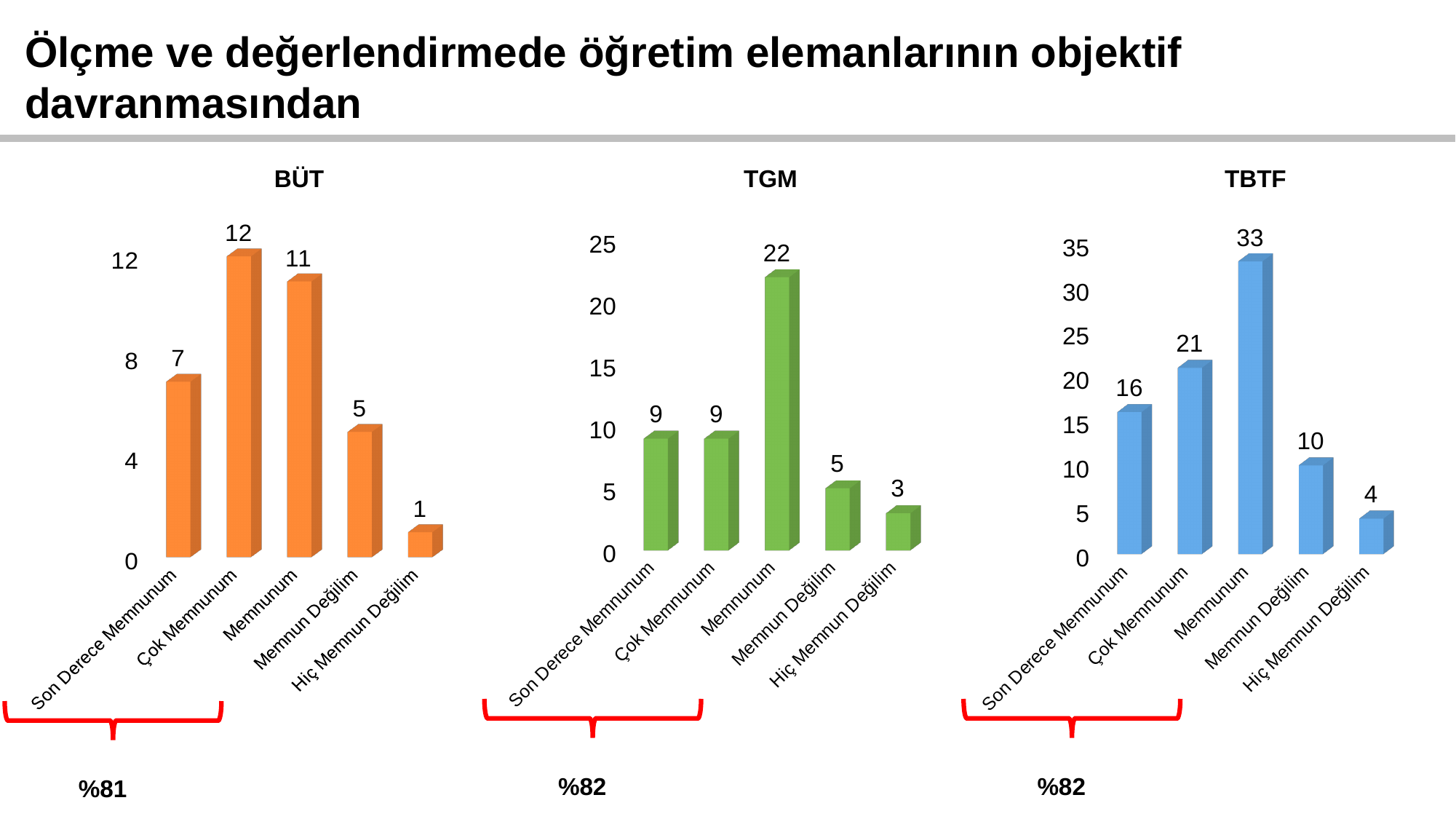
What kind of chart is the BÜT chart? bar chart In the BÜT chart, what is the difference between Memnunum and Memnun Değilim? 6 How many categories does the TGM chart show? 5 In the TBTF chart, which is larger: Son Derece Memnunum or Memnun Değilim? Son Derece Memnunum In the TGM chart, what is the value for Memnunum? 22 In the BÜT chart, what is the value for Çok Memnunum? 12 What colour are the bars in the TGM chart? green In the TBTF chart, what is the value for Hiç Memnun Değilim? 4 In the TBTF chart, which category has the highest value? Memnunum In the BÜT chart, which category has the lowest value? Hiç Memnun Değilim In the TGM chart, what is the difference between Memnunum and Çok Memnunum? 13 What percentage is shown below the TBTF chart? %82